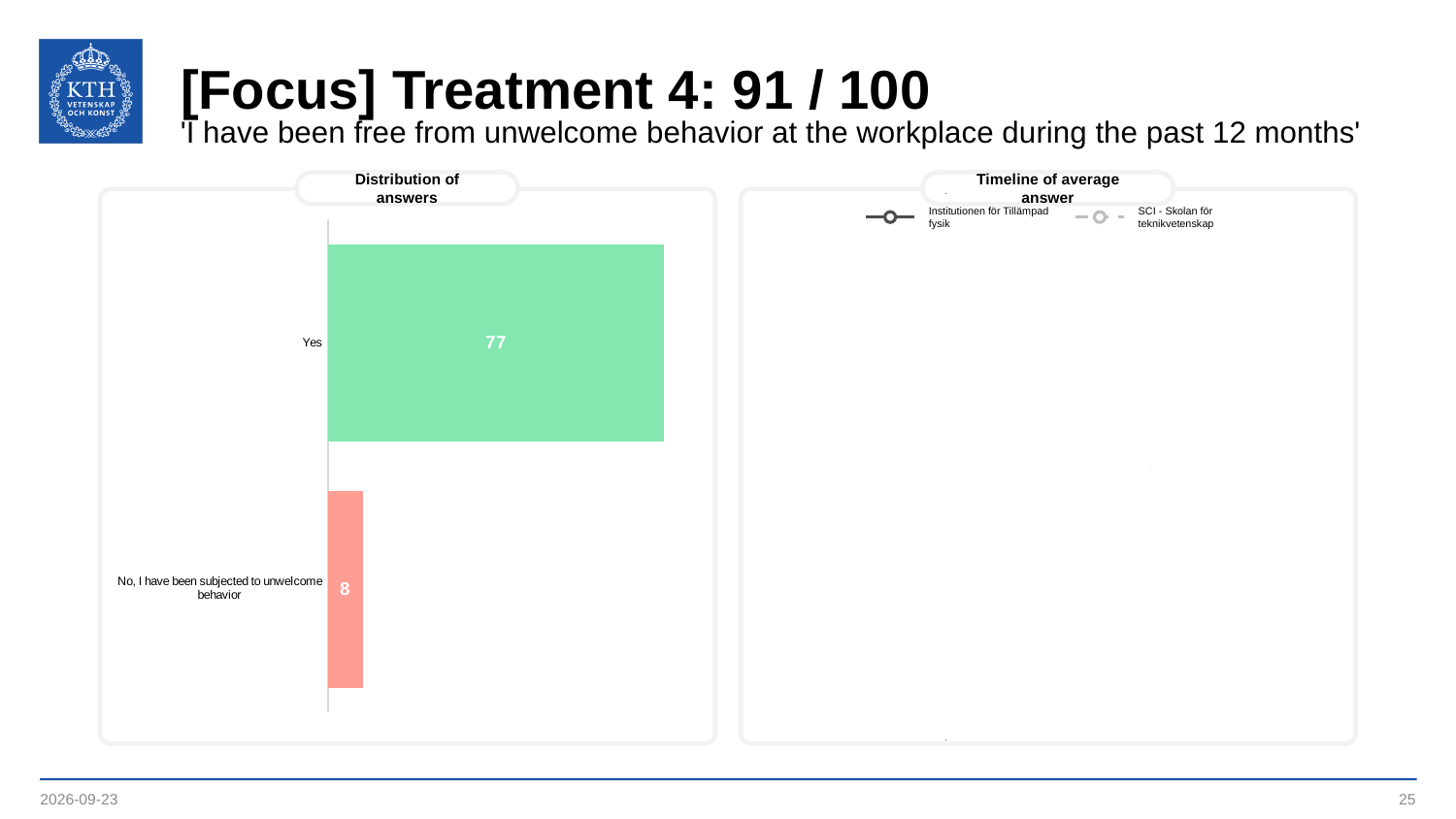
In the 'Distribution of answers' chart, what is the total of the two bar values? 85 In the 'Distribution of answers' chart, what colour is the bar for 'Yes'? Green In the 'Distribution of answers' chart, what is the difference between the 'Yes' value and the 'No, I have been subjected to unwelcome behavior' value? 69 In the 'Distribution of answers' chart, what is the value for 'No, I have been subjected to unwelcome behavior'? 8 In the 'Distribution of answers' chart, which is larger: the value for 'Yes' or the value for 'No, I have been subjected to unwelcome behavior'? Yes How many categories are shown in the 'Distribution of answers' chart? 2 In the 'Distribution of answers' chart, what is the value for 'Yes'? 77 In the 'Distribution of answers' chart, which category has the highest value? Yes In the 'Distribution of answers' chart, which category has the lowest value? No, I have been subjected to unwelcome behavior How many series does the legend of the 'Timeline of average answer' chart list? 2 What is the title of the chart on the right side of the slide? Timeline of average answer What kind of chart is the 'Distribution of answers' chart? Bar chart